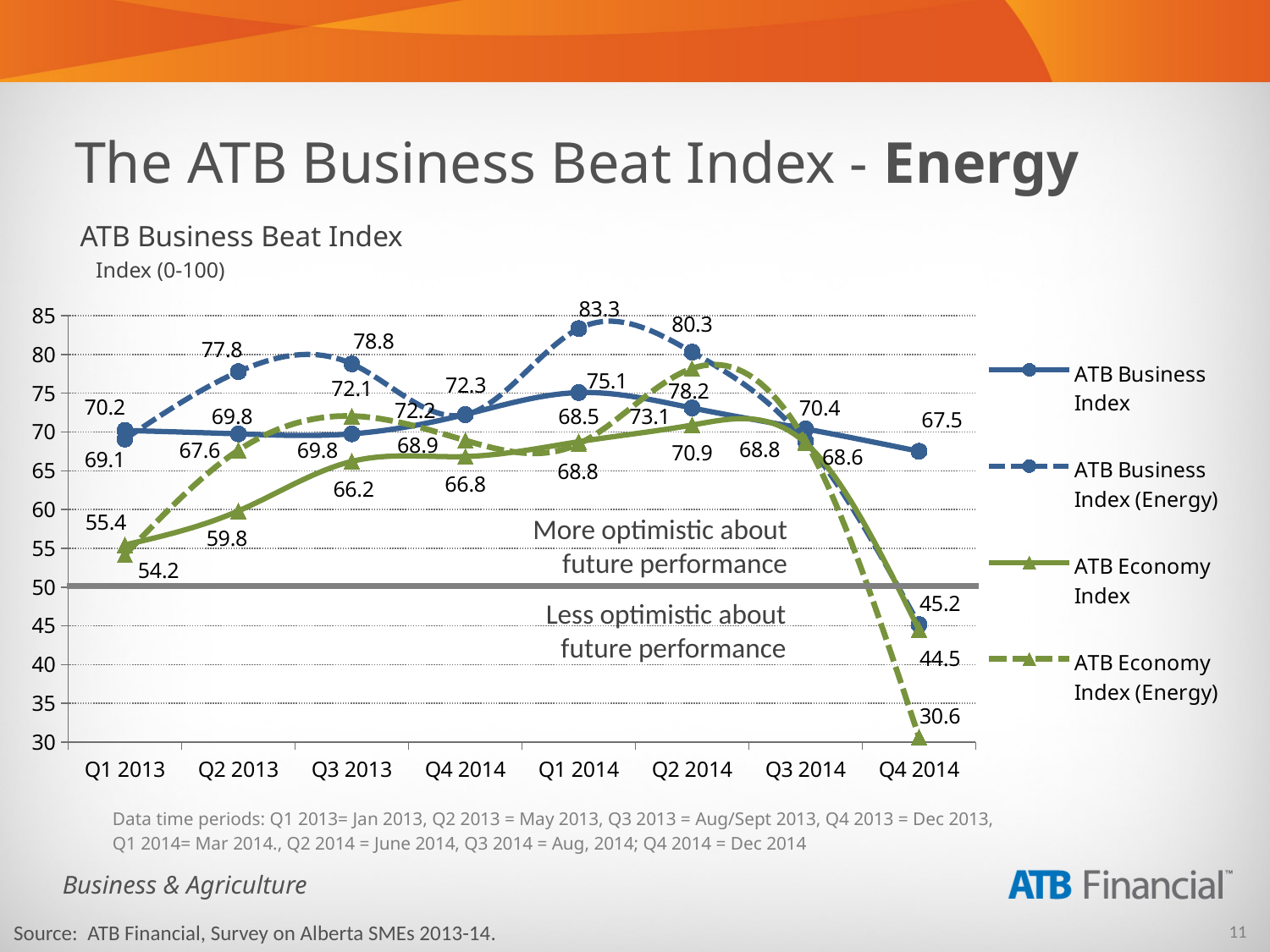
What is the value of the ATB Economy Index in Q2 2013? 59.8 Which series reaches the highest value on the chart, and in which period? ATB Business Index (Energy), Q1 2014 What is the value of the ATB Business Index (Energy) in Q1 2014? 83.3 What is the difference between the ATB Business Index (Energy) and the ATB Business Index in Q1 2014? 8.2 How many series does the legend list? 4 Which series has the lowest value on the chart? ATB Economy Index (Energy) Does the ATB Business Index (Energy) rise or fall from Q2 2014 to Q4 2014? Fall What is the value of the ATB Economy Index (Energy) in Q4 2014? 30.6 How many time periods are plotted along the x axis? 8 What is the value of the ATB Business Index in Q4 2014? 67.5 What type of chart is shown on the slide? Line chart In Q2 2014, which is larger: the ATB Business Index (Energy) or the ATB Economy Index (Energy)? ATB Business Index (Energy)